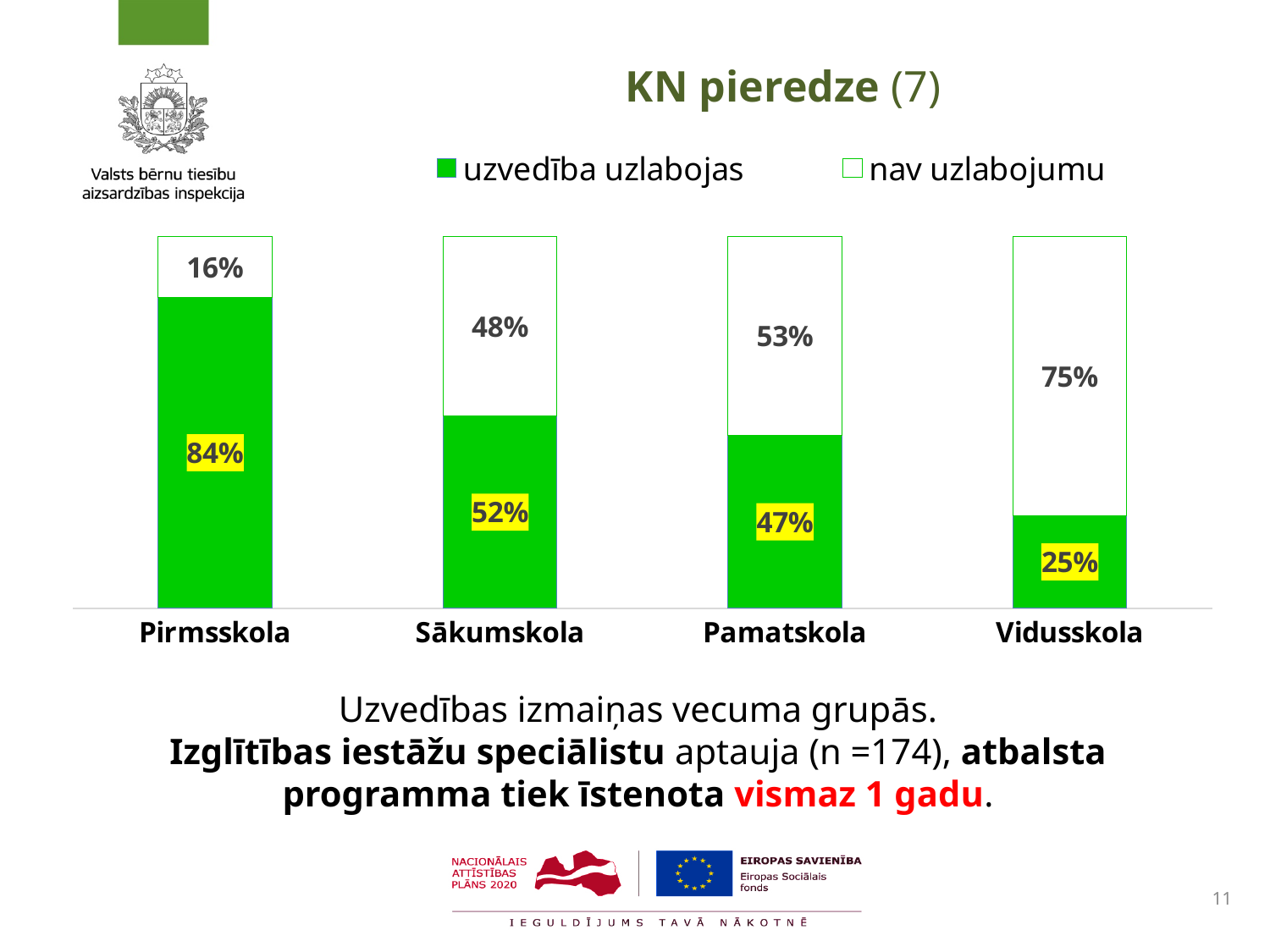
Which category has the highest value for "uzvedība uzlabojas"? Pirmsskola How many series does the legend list? 2 How many categories are shown on the x axis? 4 What is the value of "uzvedība uzlabojas" for Pamatskola? 47% Does the "uzvedība uzlabojas" value rise or fall from Pirmsskola to Vidusskola? Fall Which category has the lowest value for "uzvedība uzlabojas"? Vidusskola What is the value of "uzvedība uzlabojas" for Pirmsskola? 84% What is the value of "nav uzlabojumu" for Sākumskola? 48% Which is larger: "nav uzlabojumu" for Pamatskola or for Sākumskola? Pamatskola What is the value of "nav uzlabojumu" for Vidusskola? 75% What kind of chart is shown on the slide? Stacked bar chart What is the difference between the "uzvedība uzlabojas" values for Pirmsskola and Vidusskola? 59%